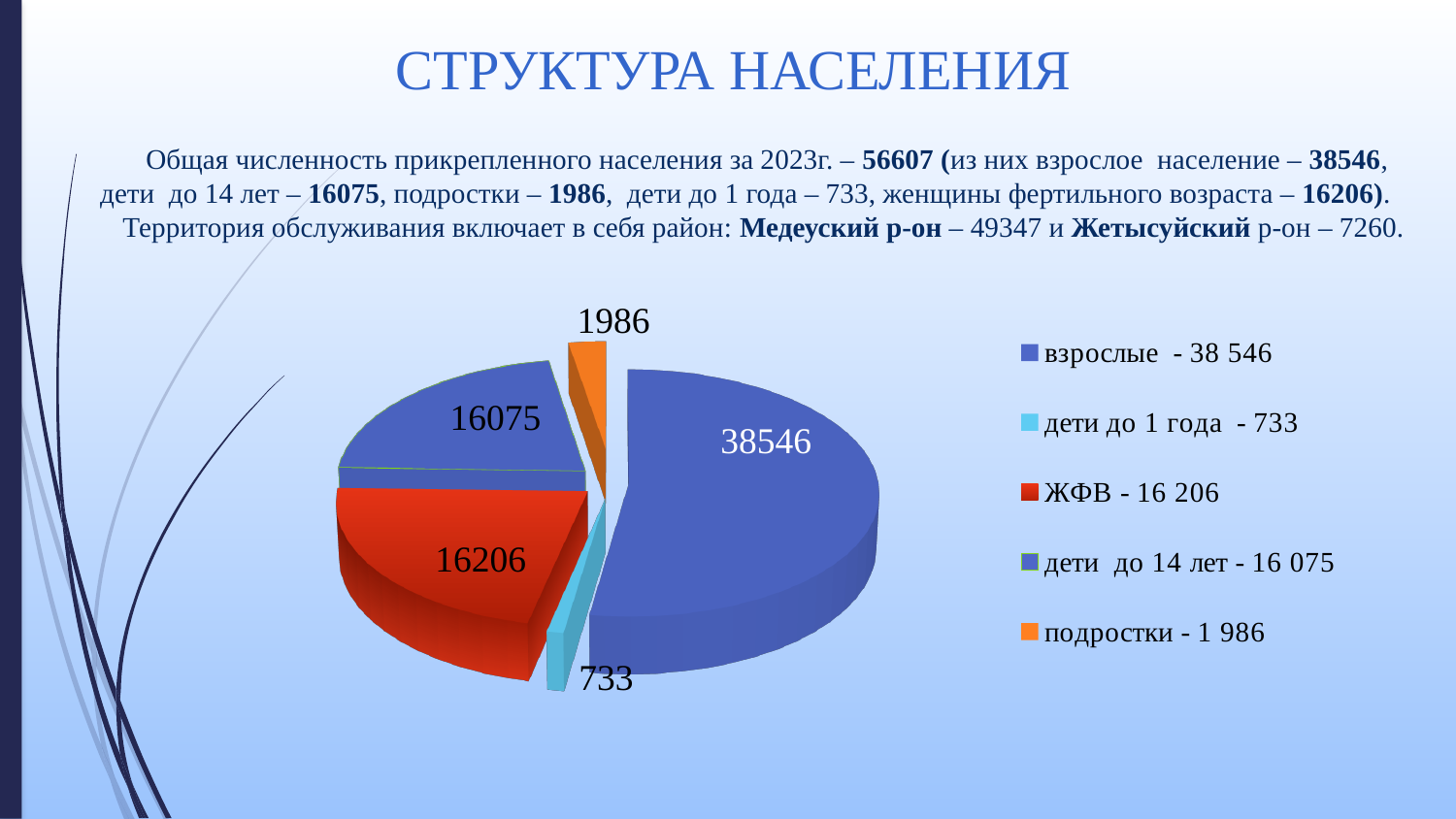
What is the value shown for the ЖФВ slice of the pie chart? 16206 How many entries does the legend of the pie chart list? 5 What is the difference between the взрослые value and the ЖФВ value in the pie chart? 22340 How many slices does the pie chart have? 5 Which category has the smallest slice in the pie chart? дети до 1 года What is the value shown for the подростки slice of the pie chart? 1986 Which is larger in the pie chart: подростки or дети до 1 года? подростки Which category has the largest slice in the pie chart? взрослые What kind of chart is shown on the slide? pie chart What is the difference between the ЖФВ value and the дети до 14 лет value in the pie chart? 131 What is the value shown for the дети до 1 года slice of the pie chart? 733 What is the value shown for the взрослые slice of the pie chart? 38546